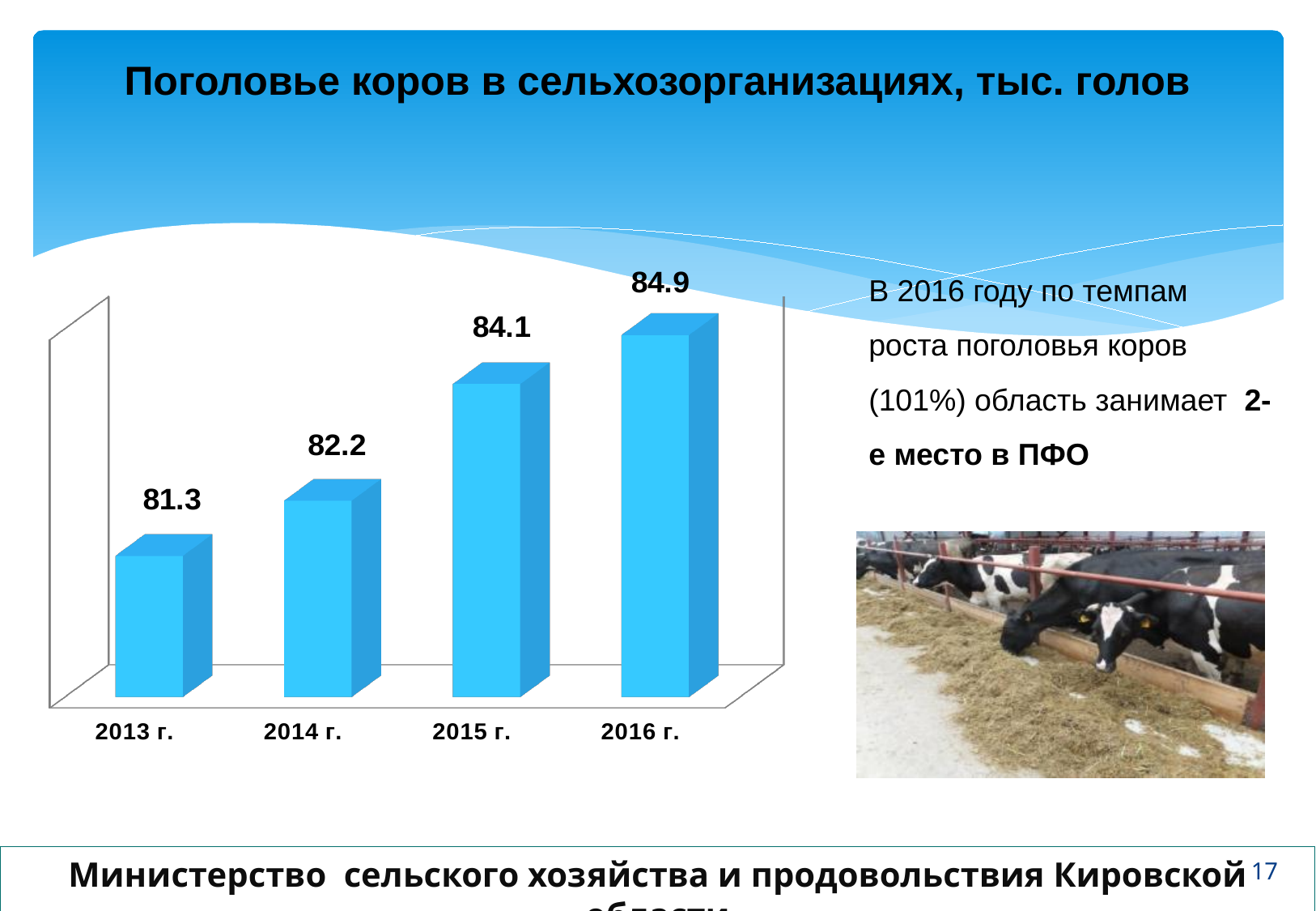
Which is larger, the value for 2014 г. or the value for 2015 г.? 2015 г. What is the difference between the values for 2015 г. and 2014 г.? 1.9 What is the value for 2013 г.? 81.3 Which year has the highest value? 2016 г. What is the value for 2015 г.? 84.1 What is the difference between the values for 2016 г. and 2013 г.? 3.6 Which year has the lowest value? 2013 г. What is the value for 2016 г.? 84.9 What is the value for 2014 г.? 82.2 How many years are shown on the chart? 4 What kind of chart is shown? bar chart Do the values rise or fall from 2013 г. to 2016 г.? rise